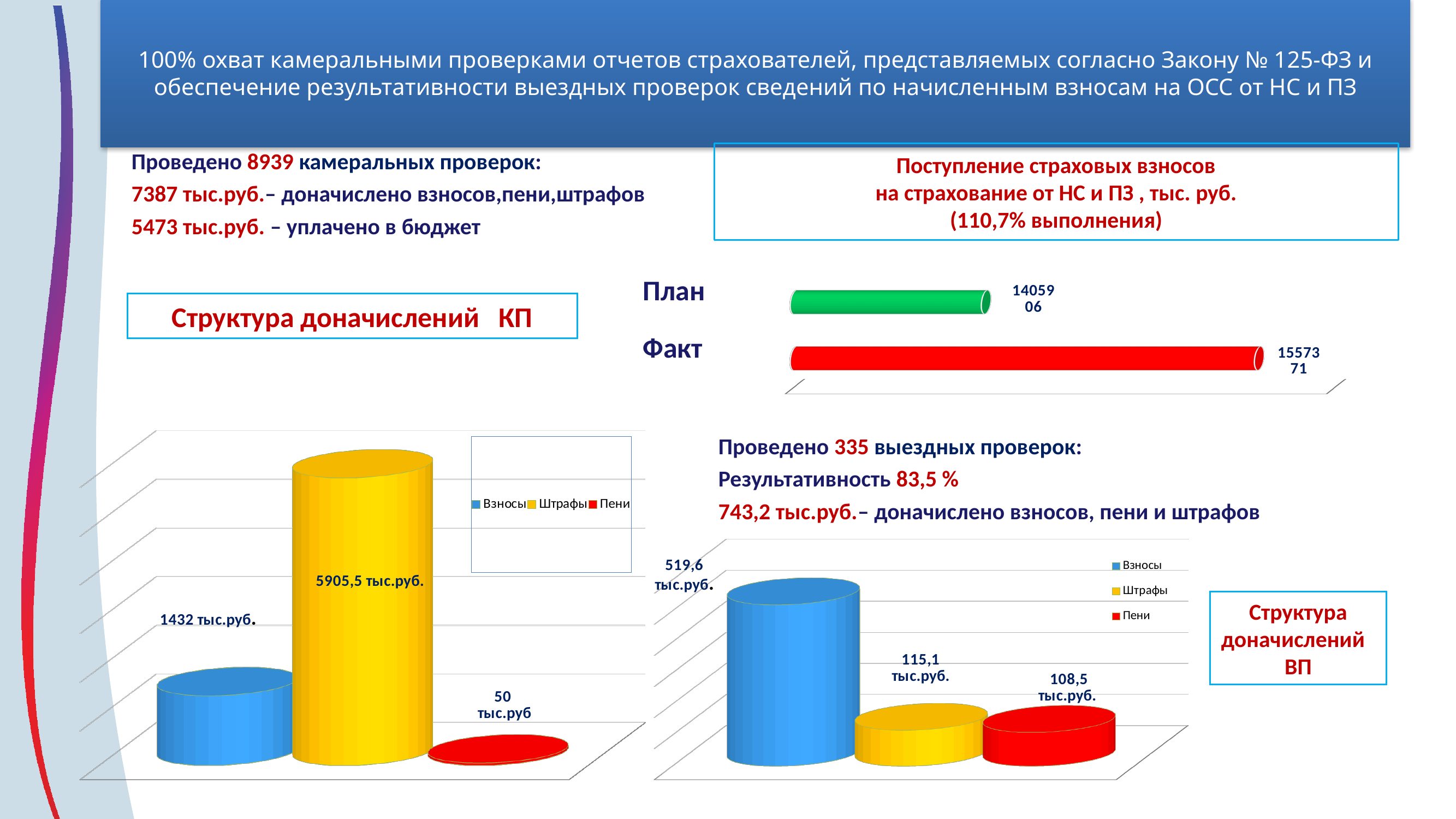
In the 'Структура доначислений ВП' chart, what is the value for Пени? 108,5 тыс.руб. In the 'Структура доначислений КП' chart, what is the value for Штрафы? 5905,5 тыс.руб. In the 'Структура доначислений ВП' chart, what is the value for Взносы? 519,6 тыс.руб. How many series does the legend of the 'Структура доначислений ВП' chart list? 3 In the 'Структура доначислений КП' chart, which category has the lowest value? Пени In the 'Структура доначислений КП' chart, which category has the highest value? Штрафы In the 'Структура доначислений ВП' chart, what is the difference between Взносы and Штрафы? 404,5 тыс.руб. In the 'Структура доначислений КП' chart, what is the value for Пени? 50 тыс.руб In the 'Структура доначислений ВП' chart, which category has the highest value? Взносы In the 'Структура доначислений КП' chart, what is the value for Взносы? 1432 тыс.руб. In the 'Поступление страховых взносов' chart, which bar is longer, План or Факт? Факт In the 'Структура доначислений ВП' chart, what is the value for Штрафы? 115,1 тыс.руб.